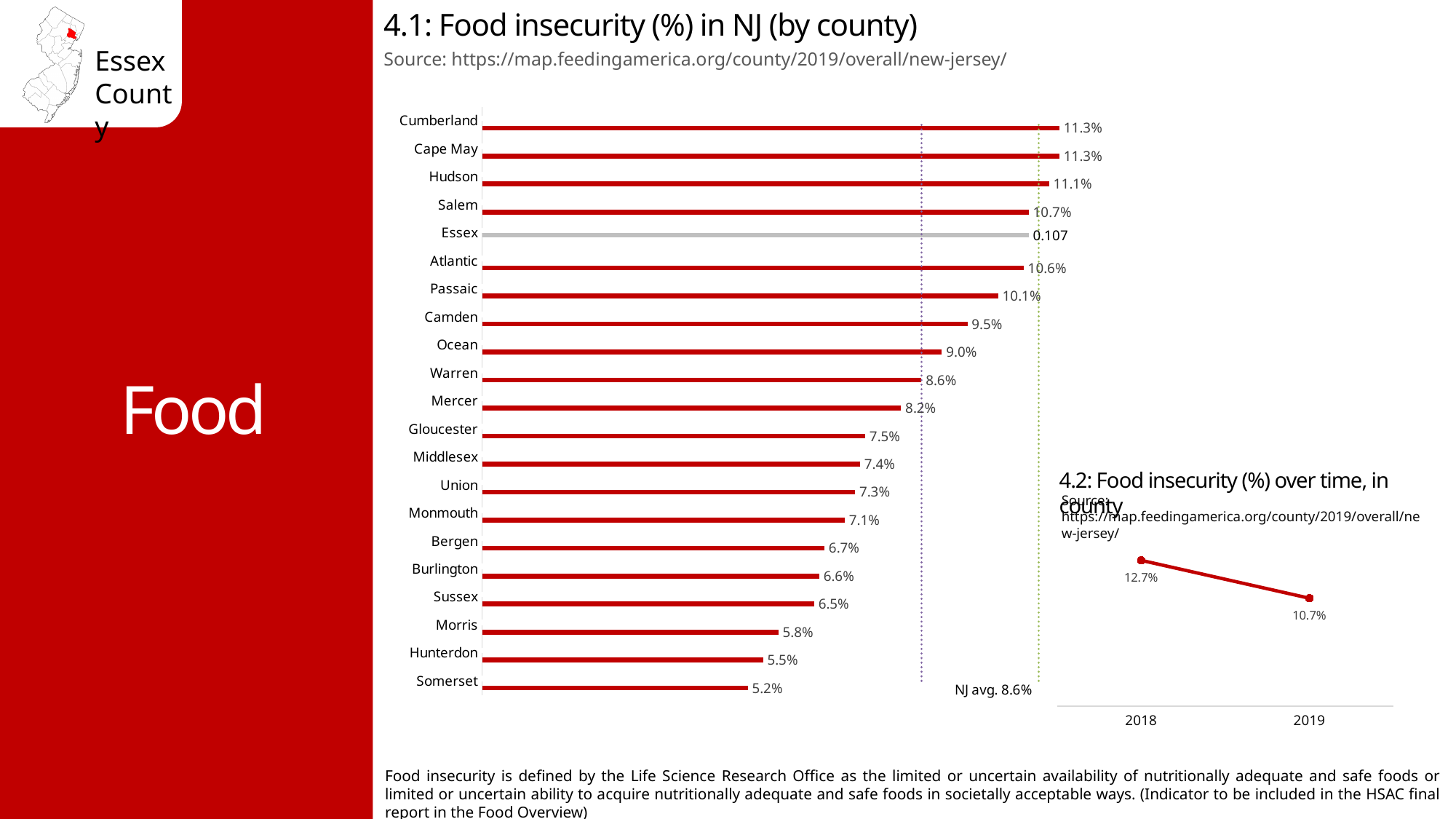
In chart 4.1, what is the difference between the values for Hudson and Somerset? 5.9 percentage points In chart 4.2, what is the difference between the 2018 and 2019 values? 2.0 percentage points In chart 4.1, which county has the lowest food insecurity value? Somerset In chart 4.1, which has the larger value, Camden or Mercer? Camden In chart 4.2, does the value rise or fall from 2018 to 2019? Fall In chart 4.2 (Food insecurity (%) over time, in county), what is the value for 2018? 12.7% In chart 4.1, how many counties are plotted? 21 What kind of chart is chart 4.1? Bar chart In chart 4.1 (Food insecurity (%) in NJ by county), what is the value for Hudson? 11.1% In chart 4.1, what is the value for Somerset? 5.2% In chart 4.1, what NJ average value is noted on the chart? 8.6% In chart 4.1, what label is printed on the Essex bar? 0.107